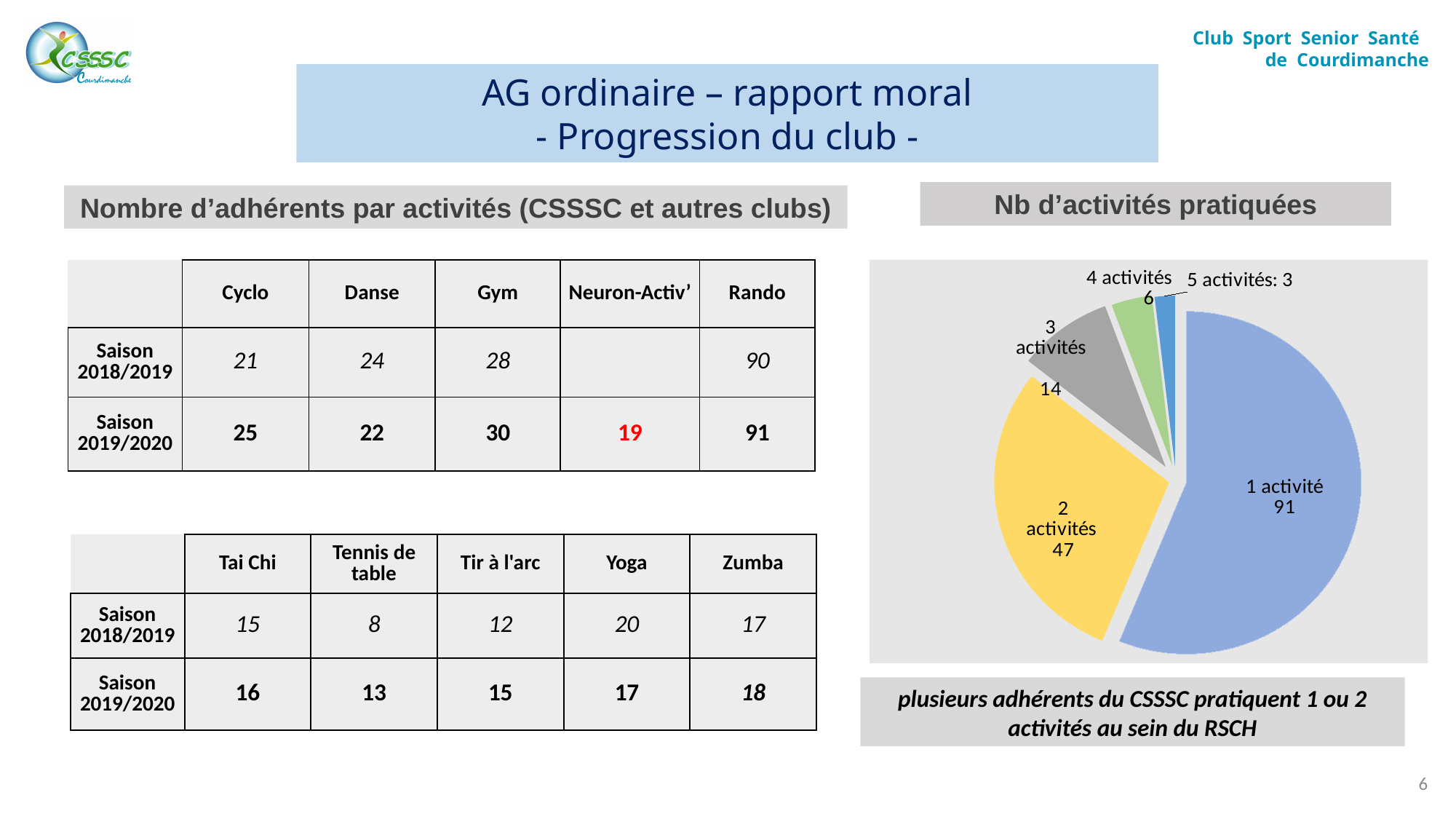
Which slice of the pie chart is the largest? 1 activité In the pie chart, what is the value for 4 activités? 6 In the pie chart, what is the value for 3 activités? 14 Which slice of the pie chart is the smallest? 5 activités In the pie chart, what is the value for 5 activités? 3 In the pie chart, what is the difference between the values for 1 activité and 2 activités? 44 What kind of chart is shown under the heading "Nb d'activités pratiquées"? pie chart What colour is the 2 activités slice in the pie chart? yellow How many slices does the pie chart have? 5 In the pie chart, what is the value for 2 activités? 47 In the pie chart, which is larger: 3 activités or 4 activités? 3 activités In the pie chart, how many members practise 1 activité? 91